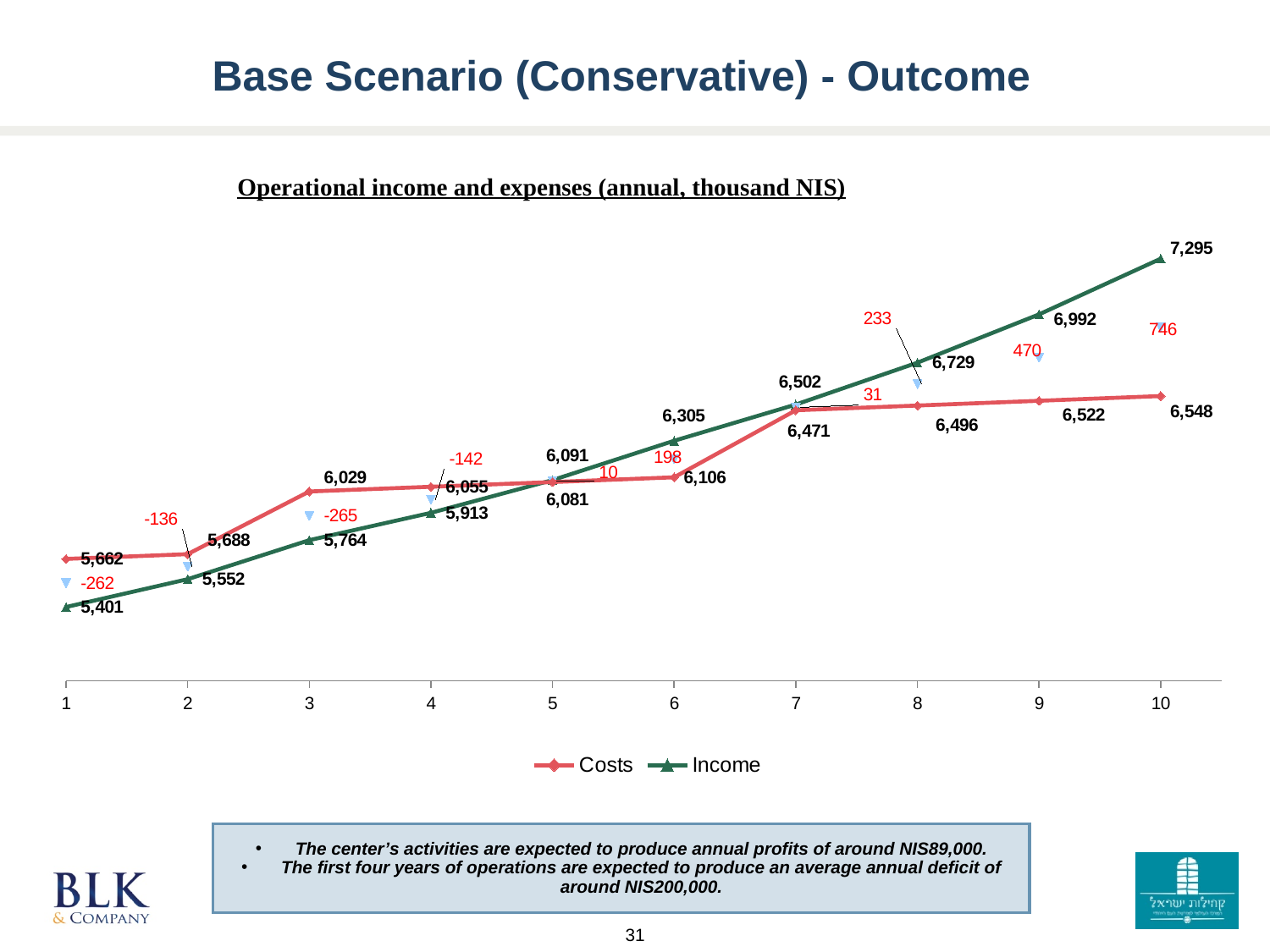
Which is larger in year 3, Costs or Income? Costs What is the difference between Income and Costs in year 10? 747 What is the value of Income in year 5? 6,091 Which is larger in year 9, Costs or Income? Income What is the value of Costs in year 7? 6,471 How many series does the legend list? 2 What kind of chart is this? Line chart In which year is Income lowest? 1 What is the value of Income in year 10? 7,295 In which year is Income highest? 10 How many years are shown on the x axis? 10 What is the value of Costs in year 1? 5,662